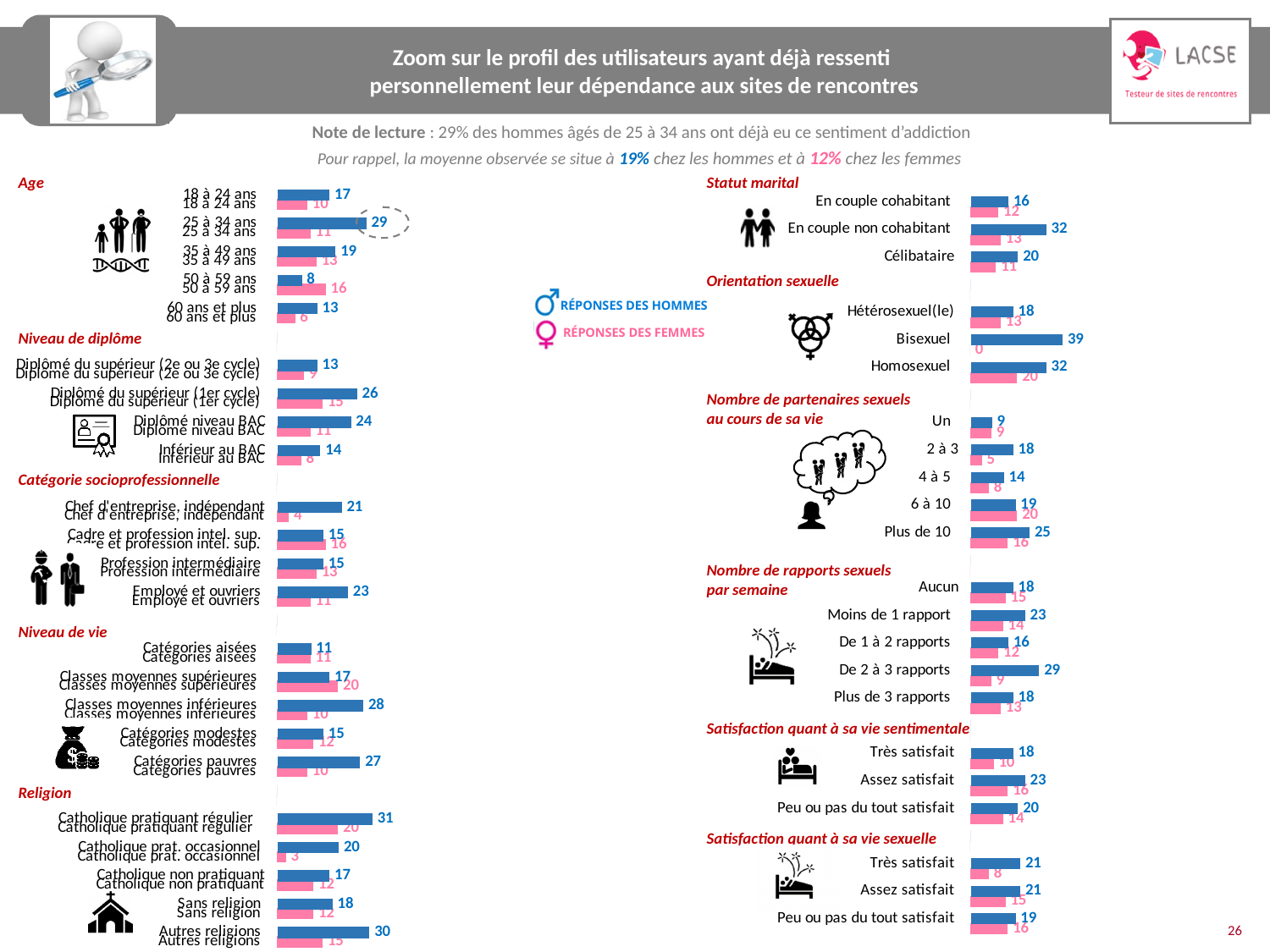
What type of chart is used for the 'Niveau de vie' data? Bar chart How many series does the legend list for the charts on this slide? 2 In the 'Age' chart, what is the value for men (réponses des hommes) aged 25 à 34 ans? 29 In the 'Catégorie socioprofessionnelle' chart, is the men's value for 'Chef d'entreprise, indépendant' larger or smaller than the women's value? larger In the 'Religion' chart, which category has the lowest value for women? Catholique prat. occasionnel In the 'Age' chart, which age group has the highest value for men? 25 à 34 ans How many categories are shown in the 'Nombre de partenaires sexuels au cours de sa vie' chart? 5 In the 'Statut marital' chart, what is the difference between the men's and women's values for 'En couple non cohabitant'? 19 In the 'Age' chart, what is the value for women (réponses des femmes) aged 50 à 59 ans? 16 In the 'Orientation sexuelle' chart, what is the value for men who are Bisexuel? 39 In the 'Orientation sexuelle' chart, what is the value for women who are Bisexuel? 0 In the 'Nombre de rapports sexuels par semaine' chart, which category has the highest value for men? De 2 à 3 rapports